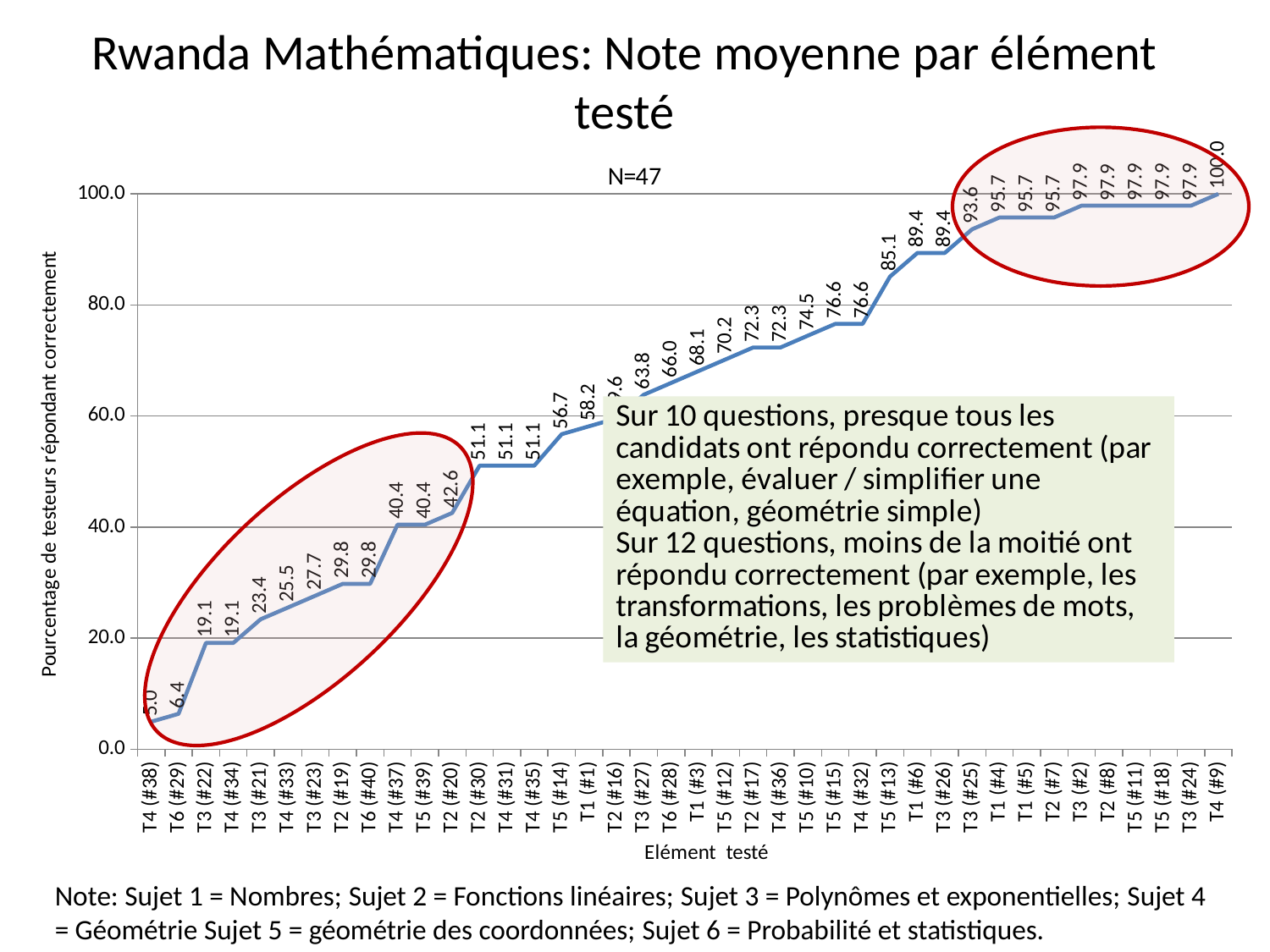
What kind of chart is shown on the slide? line chart Is the value for T2 (#16) greater or less than 40.0? greater What is the value for T6 (#29)? 6.4 Which is larger, the value for T3 (#21) or the value for T5 (#14)? T5 (#14) What sample size (N) is shown below the chart title? N=47 Which tested element has the lowest average score? T4 (#38) Which tested element has the highest average score? T4 (#9) What is the difference between the values for T4 (#9) and T4 (#38)? 95.0 What is the value for T3 (#25)? 93.6 What is the value for T5 (#13)? 85.1 Do the values rise or fall from left to right along the x axis? rise What is the value for T2 (#20)? 42.6